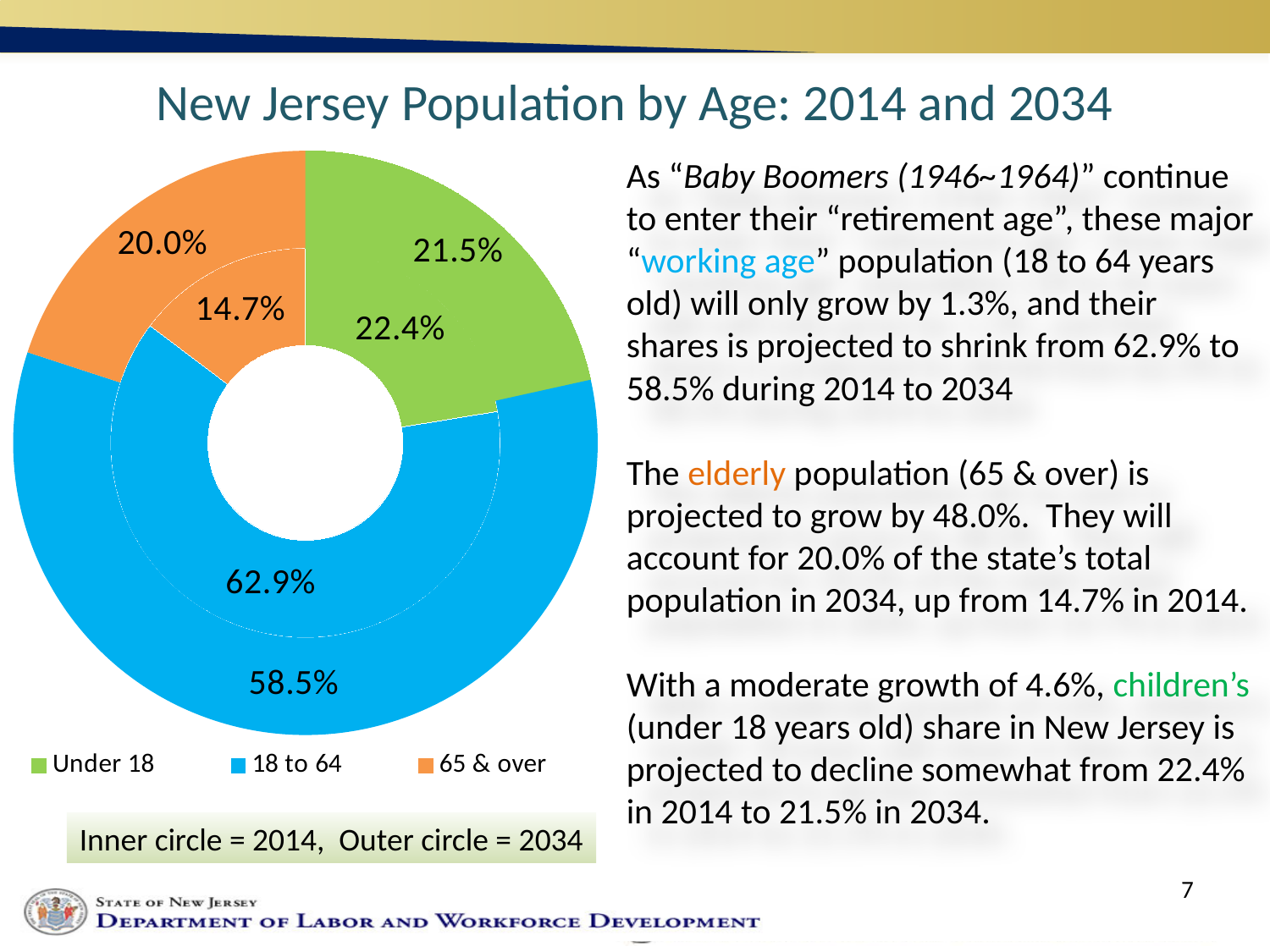
What share of New Jersey's population is projected to be 65 & over in 2034 (outer circle)? 20.0% By how many percentage points does the 65 & over share rise from 2014 to 2034? 5.3 percentage points By how many percentage points does the 18 to 64 share fall from 2014 to 2034? 4.4 percentage points What share of the population was Under 18 in 2014 (inner circle)? 22.4% Which age group has the smallest share in the 2014 inner circle? 65 & over How many age groups does the legend list? 3 Which age group has the largest share in the 2034 outer circle? 18 to 64 What type of chart is shown on the slide? Doughnut chart What share of New Jersey's population was aged 18 to 64 in 2014 (inner circle)? 62.9% Which is larger in 2034: the Under 18 share or the 65 & over share? Under 18 Which ring of the chart represents 2034? Outer circle What share of the population is projected to be 18 to 64 in 2034 (outer circle)? 58.5%